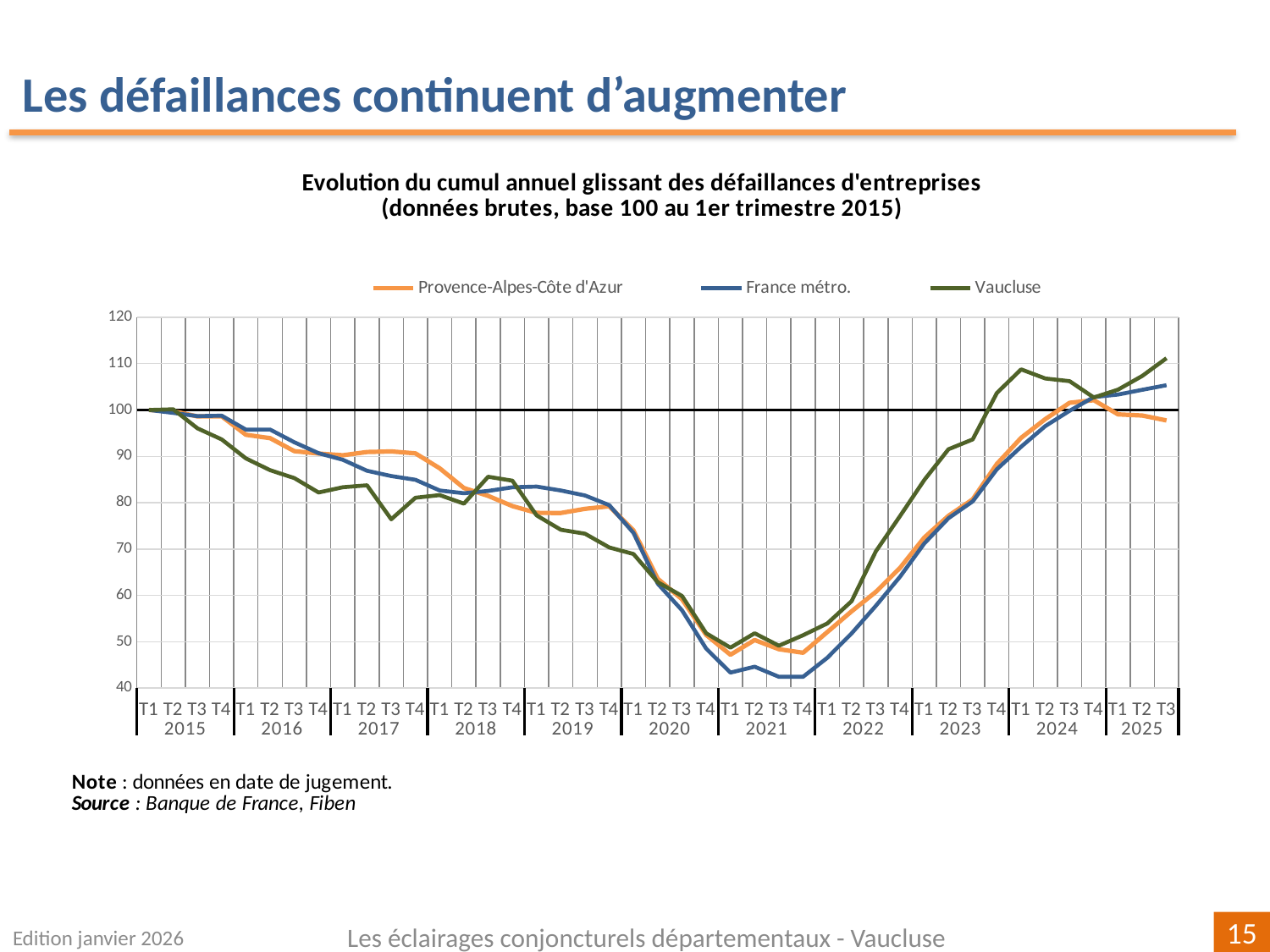
Is the value for Vaucluse at T1 2024 greater or less than 100? greater At T3 2025, which is higher: Vaucluse or France métro.? Vaucluse Is the value for France métro. at T4 2021 greater or less than 50? less How many series does the legend list? 3 Is the value for Vaucluse at T3 2025 greater or less than 100? greater At T3 2017, which is higher: Provence-Alpes-Côte d'Azur or Vaucluse? Provence-Alpes-Côte d'Azur Does the France métro. series rise or fall between T4 2021 and T3 2025? rise What is the value of each series at T1 2015, the base period? 100 Which series is shown in green in the legend? Vaucluse Which series has the lowest value at T4 2021? France métro. What kind of chart is shown on the slide? line chart